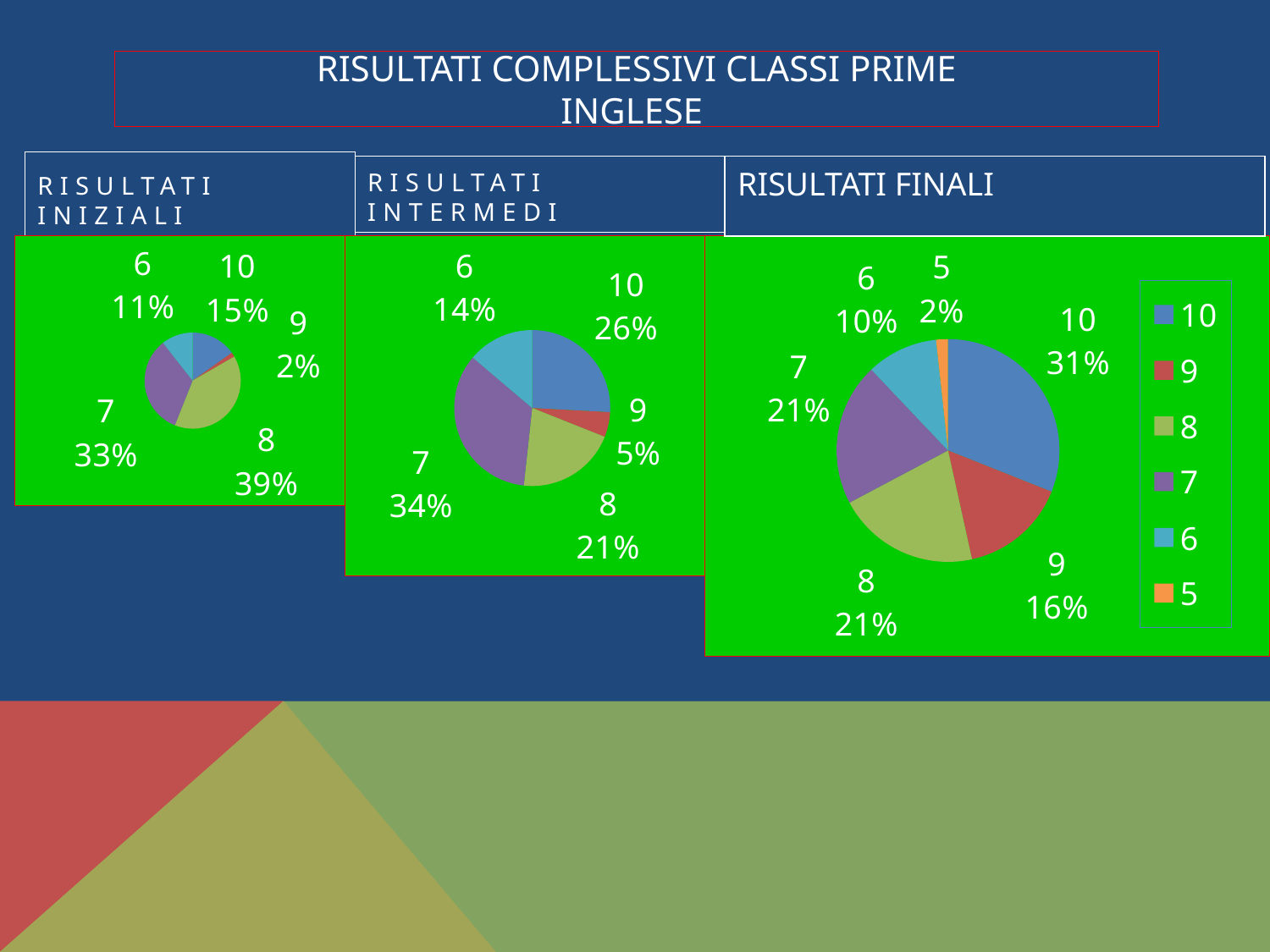
In the Risultati Iniziali chart, which grade has the smallest share? 9 In the Risultati Iniziali chart, what is the difference between the shares of grade 8 and grade 7? 6% How many entries does the legend of the Risultati Finali chart list? 6 In the Risultati Finali chart, which grade has the largest share? 10 In the Risultati Finali chart, what is the difference between the shares of grade 10 and grade 9? 15% In the Risultati Intermedi chart, what share does grade 10 have? 26% In the Risultati Intermedi chart, which grade has the largest share? 7 How many slices does the Risultati Finali chart have? 6 In the Risultati Iniziali chart, what share does grade 8 have? 39% In the Risultati Intermedi chart, which is larger, the share of grade 6 or the share of grade 9? 6 In the Risultati Finali chart, what share does grade 9 have? 16% What type of chart is the Risultati Intermedi chart? Pie chart